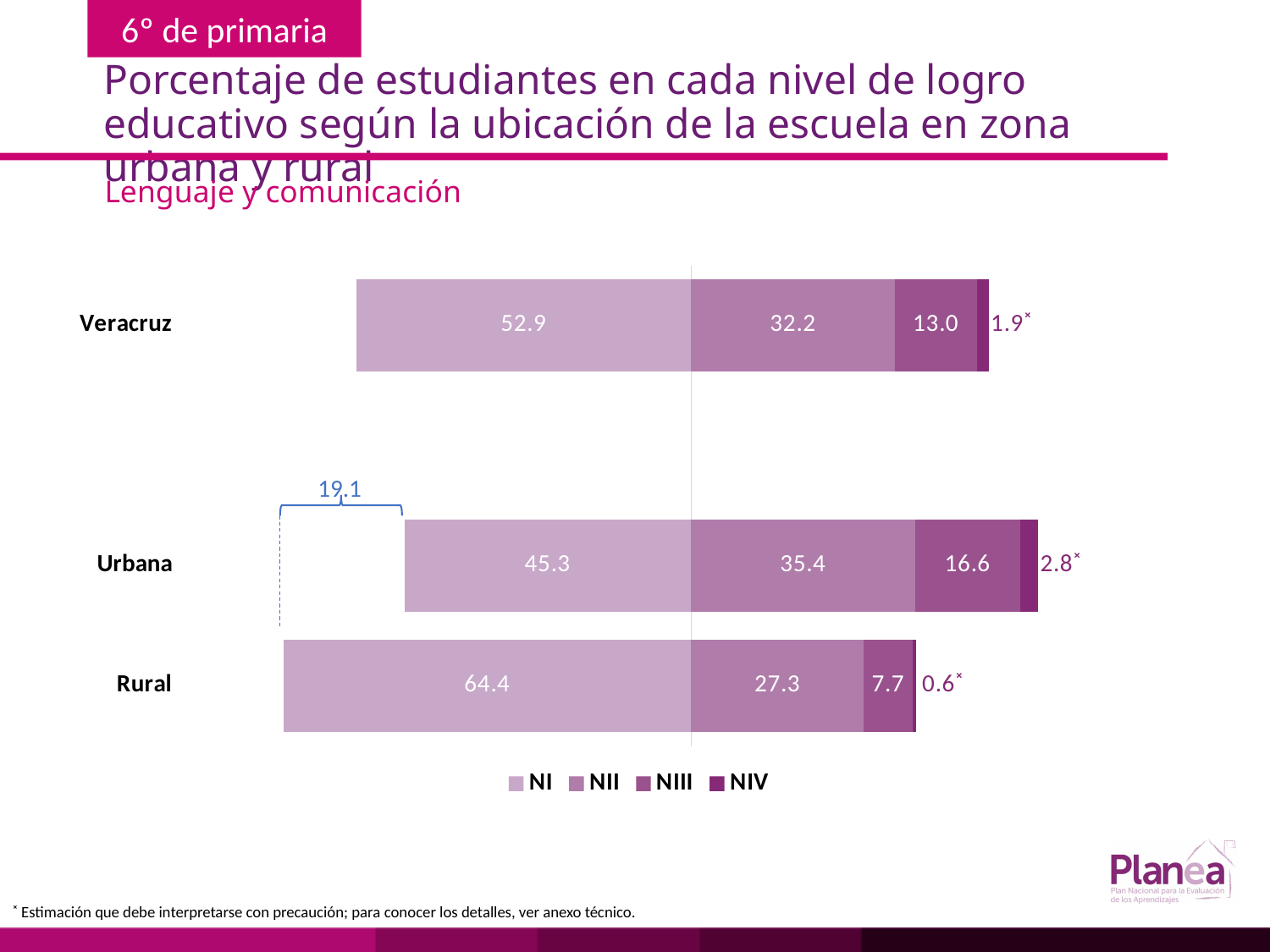
What is the NIII value for Veracruz? 13.0 Which is larger, the NII value for Veracruz or the NII value for Rural? Veracruz What is the NII value for Urbana? 35.4 How many series does the legend list? 4 What is the difference between the NI values for Rural and Urbana? 19.1 What is the total of the stacked bar for Veracruz? 100.0 How many categories (bars) are plotted in the chart? 3 Which category has the lowest NIII value? Rural Which category has the highest NI value? Rural What kind of chart is shown on the slide? Stacked bar chart What is the NIV value for Rural? 0.6 What is the NI value for Rural? 64.4